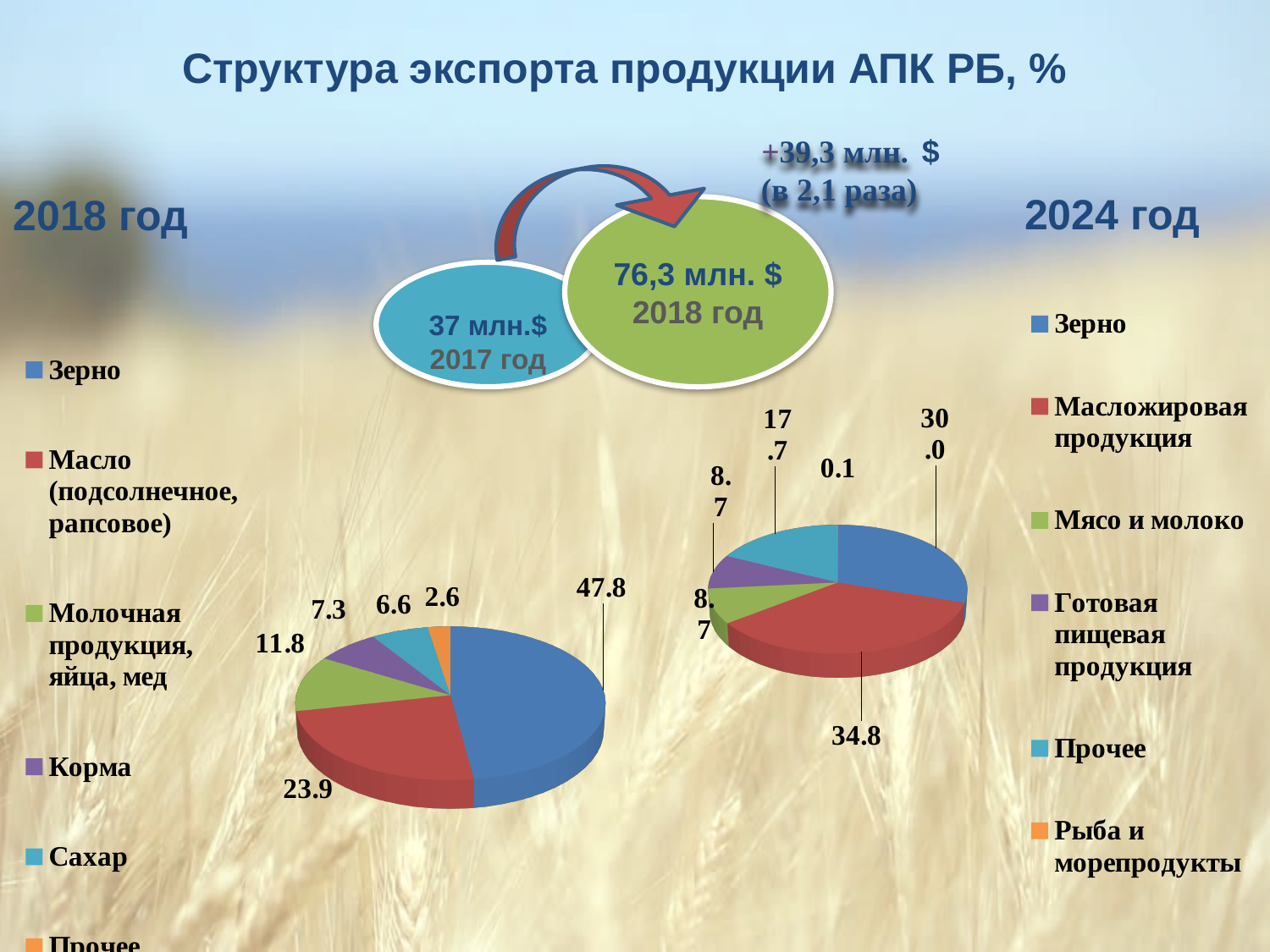
In the 2024 год pie chart, what is the value for Прочее? 17.7 In the 2024 год pie chart, which category has the smallest share? Рыба и морепродукты In the 2024 год pie chart, what is the value for Масложировая продукция? 34.8 What type of chart is used for the 2024 год data? Pie chart In the 2018 год pie chart, what is the value for Масло (подсолнечное, рапсовое)? 23.9 In the 2018 год pie chart, what is the difference between the values for Зерно and Масло (подсолнечное, рапсовое)? 23.9 In the 2024 год pie chart, which is larger: Зерно or Масложировая продукция? Масложировая продукция In the 2018 год pie chart, which category has the largest share? Зерно In the 2018 год pie chart, which category has the smallest share? Прочее In the 2024 год pie chart, which category has the largest share? Масложировая продукция In the 2018 год pie chart, what is the value for Зерно? 47.8 In the 2018 год pie chart, how many categories are shown? 6